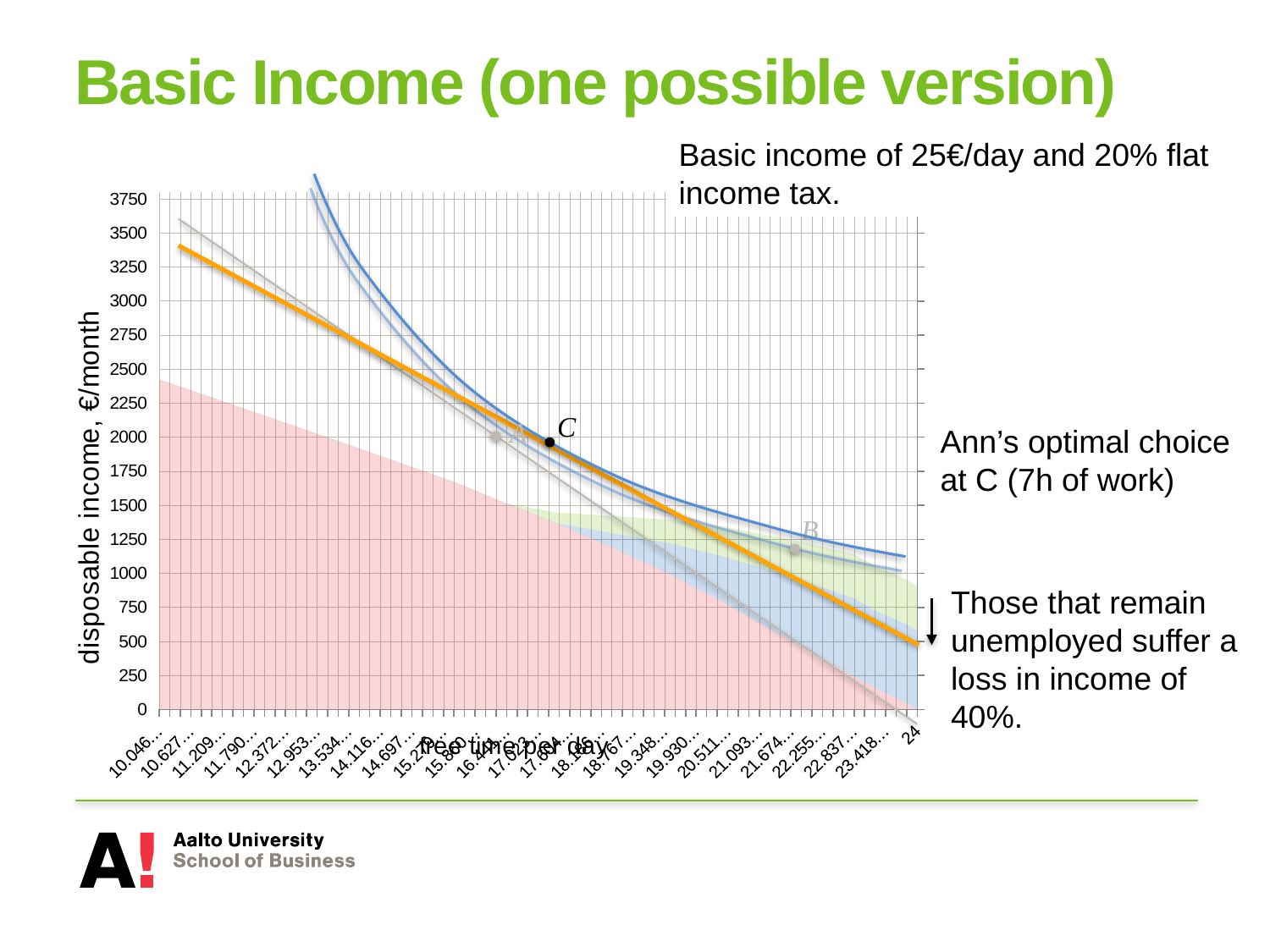
What is the title of the vertical axis on the chart? disposable income, €/month What is the highest value labelled on the vertical axis of the chart? 3750 Is the disposable income at point B greater or less than 1500? less Is the value of the orange line at the left end of the chart greater or less than 3000? greater What is the last value labelled on the horizontal axis of the chart? 24 Is the value of the orange line at the right end of the chart (free time of 24) greater or less than 1000? less Does the orange line rise or fall as free time per day increases along the x axis? fall Which point on the chart has the higher disposable income, C or B? C